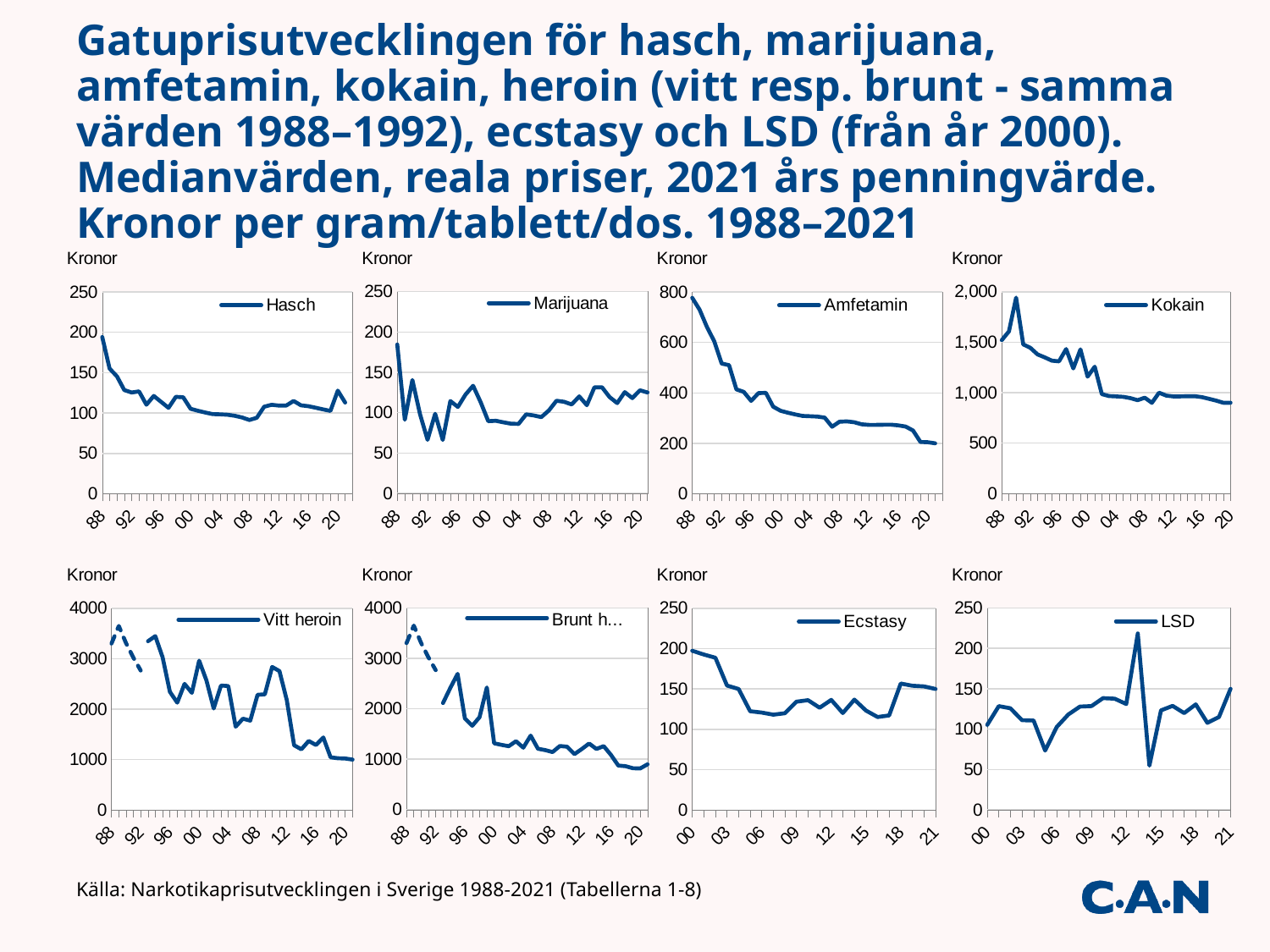
On the Hasch chart, is the value for 1988 greater or less than 150? greater On the Marijuana chart, is the value for 1988 greater or less than 150? greater On the Amfetamin chart, do the values overall rise or fall from 1988 to 2021? fall How many series does the legend of the Amfetamin chart list? 1 What label appears above the vertical axis of each chart on the slide? Kronor On the Kokain chart, is the highest value greater or less than 1,500? greater What kind of chart is the Hasch chart (top left)? line chart On the Brunt heroin chart (bottom row, second from left), do the values overall rise or fall from 1988 to 2021? fall